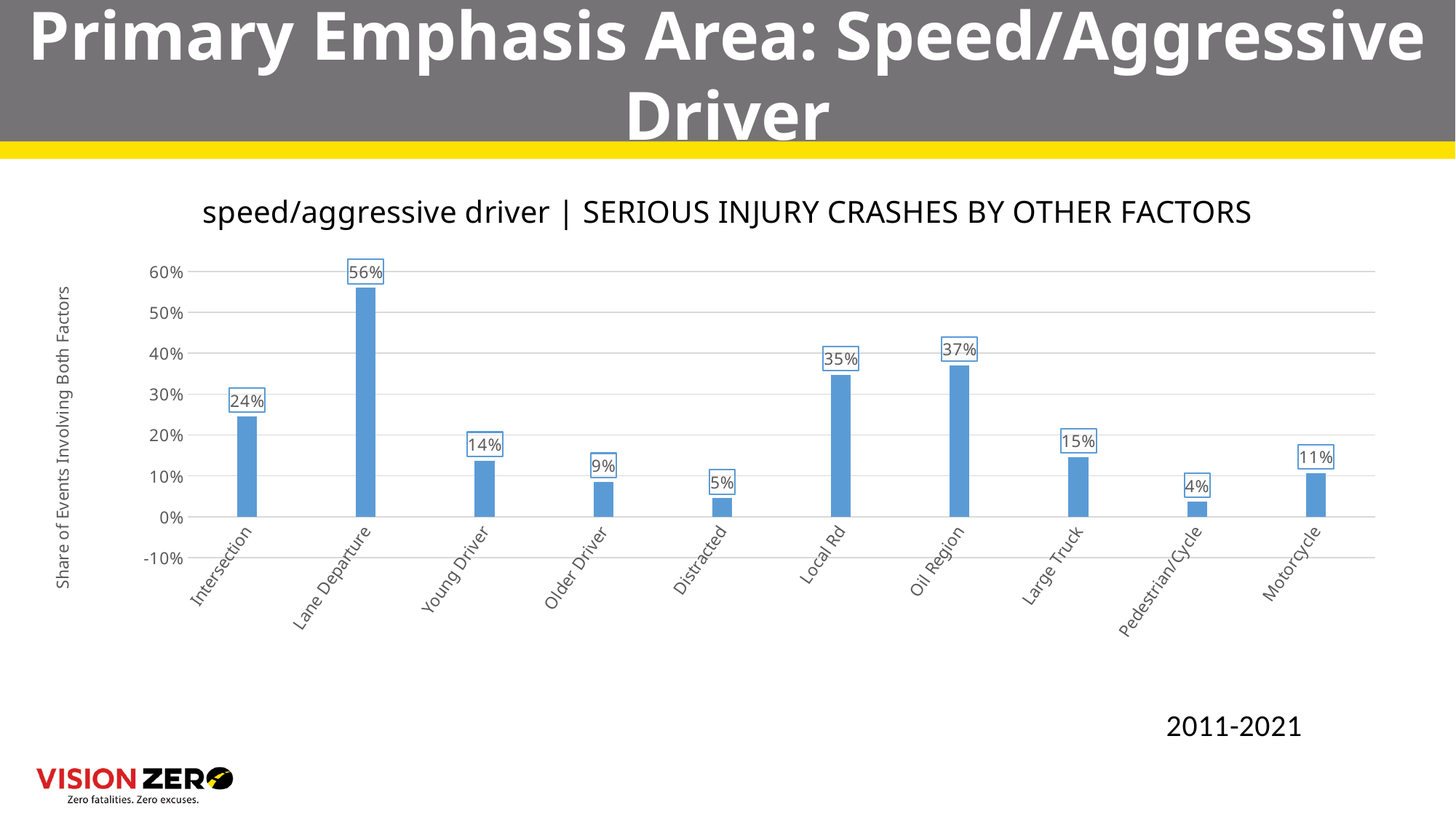
Which category has the lowest value? Pedestrian/Cycle Which category has the highest value? Lane Departure What is the value for Lane Departure? 56% Is the value for Motorcycle greater or less than 20%? less What is the label of the vertical axis? Share of Events Involving Both Factors Which is larger, the value for Local Rd or the value for Large Truck? Local Rd What is the value for Oil Region? 37% How many categories are shown on the x axis? 10 What is the title of the chart? speed/aggressive driver | SERIOUS INJURY CRASHES BY OTHER FACTORS What is the difference between the values for Lane Departure and Intersection? 32% What kind of chart is shown on the slide? bar chart What is the value for Pedestrian/Cycle? 4%